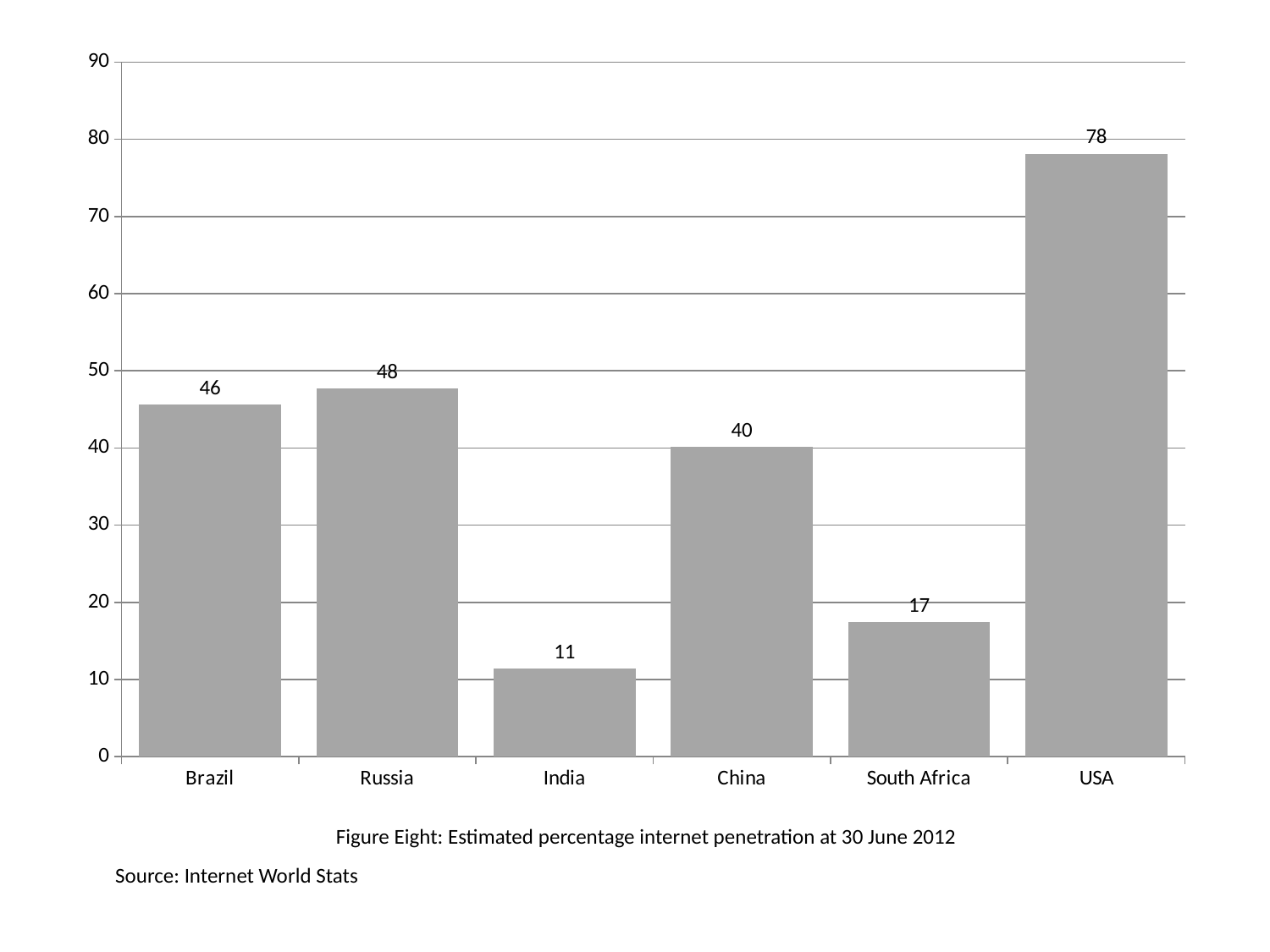
Which country has the lowest internet penetration on the chart? India What is the estimated percentage internet penetration for Brazil? 46 What kind of chart is shown on the slide? Bar chart What is the source given for the chart data? Internet World Stats What is the difference between the values for USA and China? 38 How many countries are shown on the chart? 6 What is the value shown for South Africa? 17 Which country has the highest internet penetration on the chart? USA Is the value for USA greater or less than 70? greater Which is larger, the value for China or the value for South Africa? China What is the difference between the values for Russia and Brazil? 2 What is the value shown for India? 11